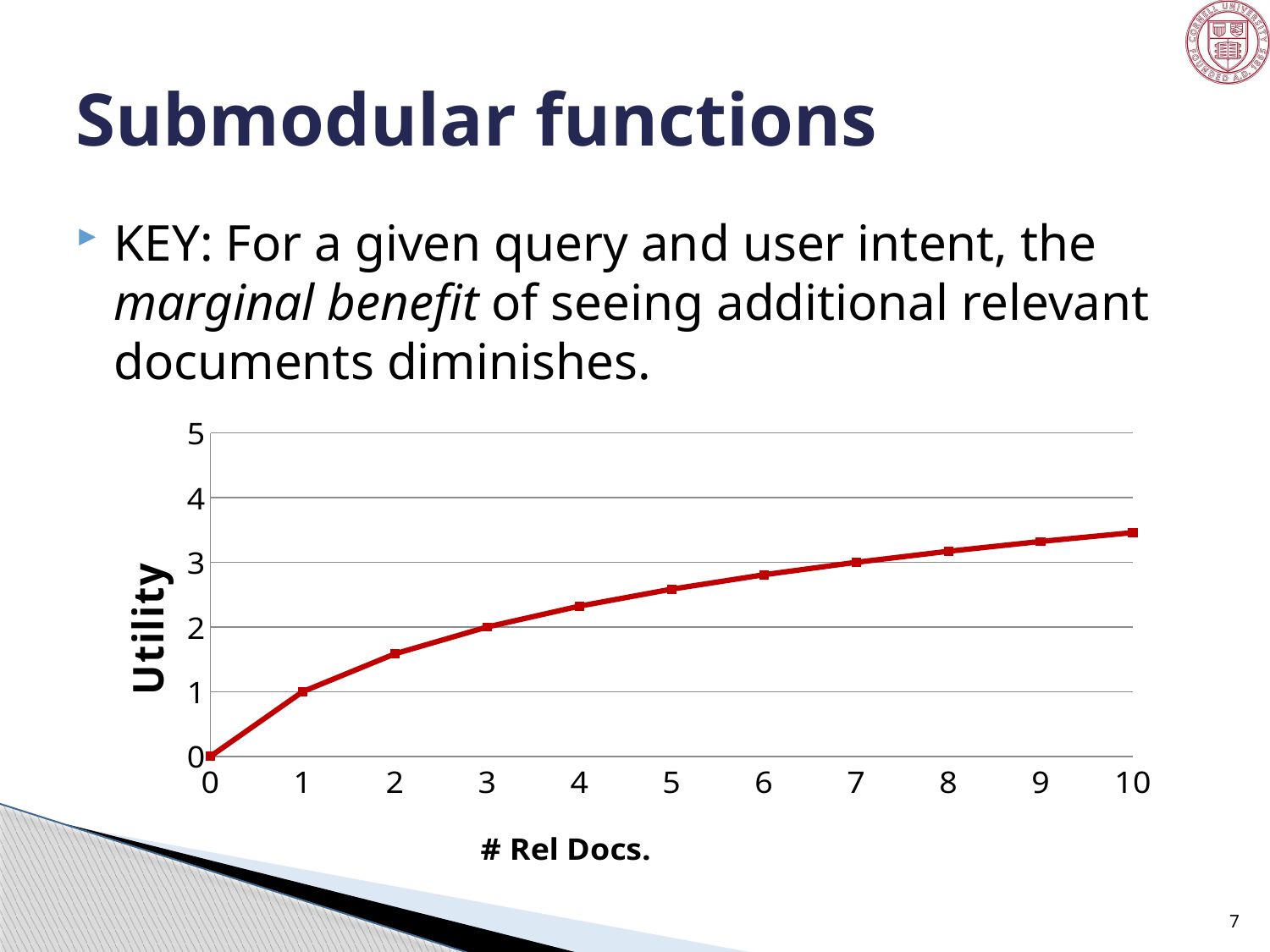
Is the Utility value at 10 Rel Docs. greater or less than 3? greater At which # Rel Docs. value is Utility highest? 10 What is the Utility value when # Rel Docs. is 3? 2 What kind of chart is shown on the slide? line chart What is the label on the x axis of the chart? # Rel Docs. Does Utility rise or fall as # Rel Docs. increases? rises What is the difference in Utility between 7 Rel Docs. and 1 Rel Doc? 2 How many data points are plotted on the line? 11 What is the Utility value when # Rel Docs. is 7? 3 What is the Utility value when # Rel Docs. is 1? 1 What is the Utility value when # Rel Docs. is 0? 0 Is the Utility value at 2 Rel Docs. greater or less than 2? less